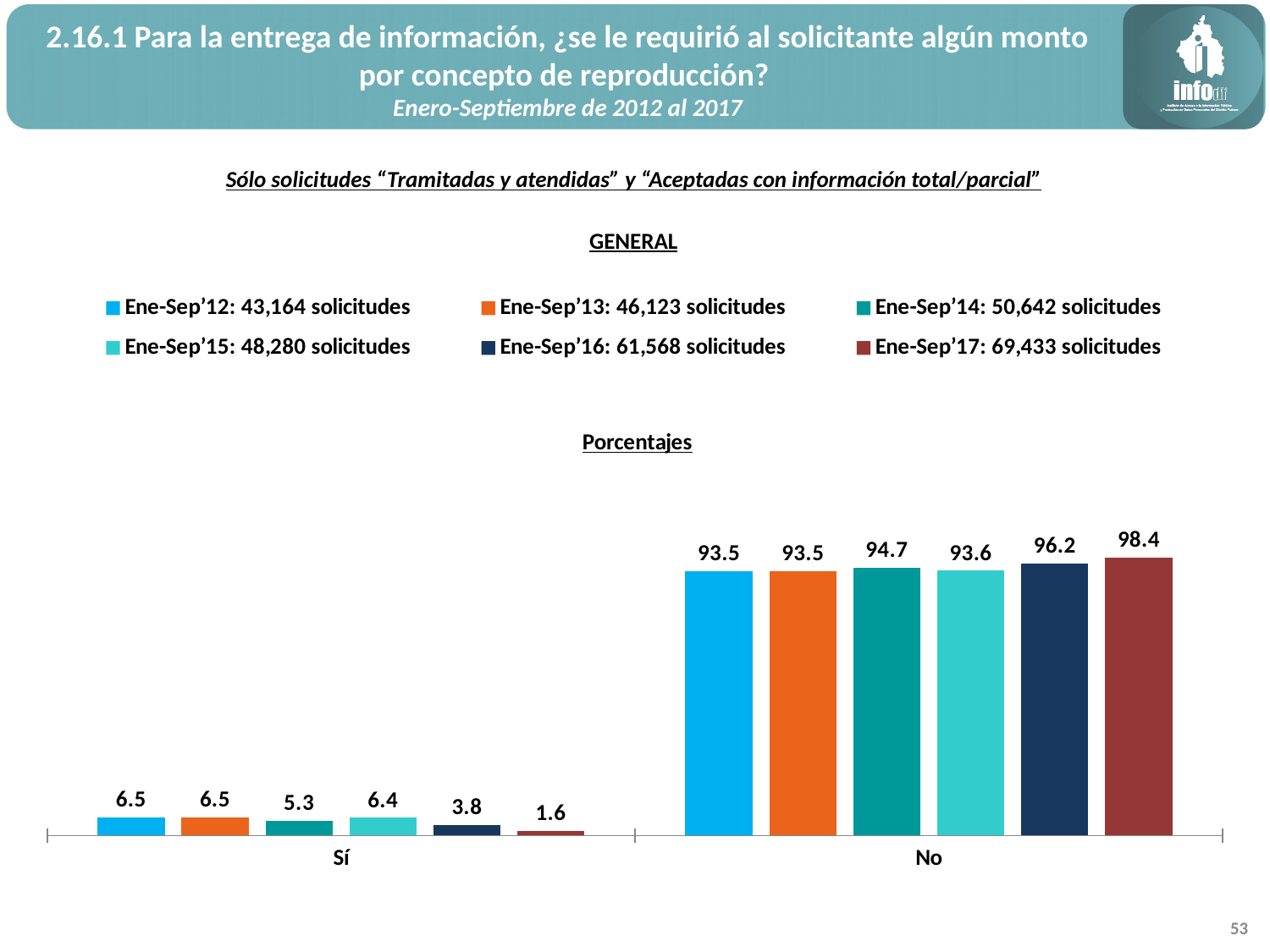
What is the value for Ene-Sep'17 in the "No" category? 98.4 What is the value for Ene-Sep'14 in the "Sí" category? 5.3 What is the difference between the Ene-Sep'12 and Ene-Sep'17 values in the "Sí" category? 4.9 Which series has the lowest value in the "Sí" category? Ene-Sep'17 Which series has the highest value in the "No" category? Ene-Sep'17 According to the legend, how many solicitudes were there in Ene-Sep'16? 61,568 What is the difference between the Ene-Sep'16 and Ene-Sep'15 values in the "No" category? 2.6 How many categories are shown on the x axis? 2 How many series does the legend list? 6 Which is larger in the "No" category: Ene-Sep'14 or Ene-Sep'15? Ene-Sep'14 What is the value for Ene-Sep'16 in the "Sí" category? 3.8 What kind of chart is shown on the slide? Bar chart